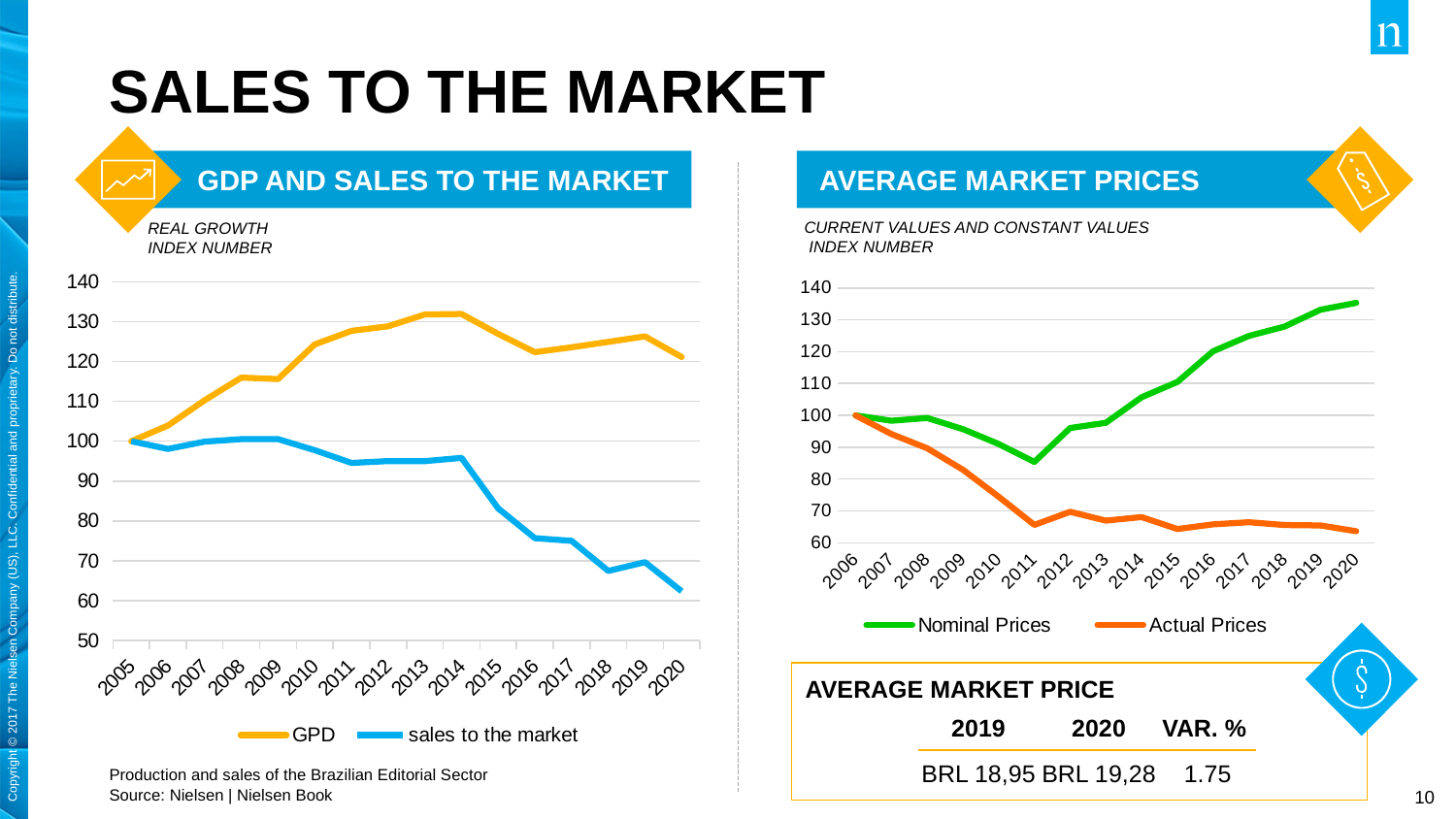
In the GDP AND SALES TO THE MARKET chart, in which year is sales to the market lowest? 2020 In the AVERAGE MARKET PRICES chart, what is the value of Nominal Prices in 2006? 100 In the GDP AND SALES TO THE MARKET chart, how many series does the legend list? 2 In the GDP AND SALES TO THE MARKET chart, which series is higher in 2014, GPD or sales to the market? GPD In the AVERAGE MARKET PRICES chart, in which year are Nominal Prices highest? 2020 In the AVERAGE MARKET PRICES chart, is the value for Actual Prices in 2020 greater or less than 70? less In the GDP AND SALES TO THE MARKET chart, does sales to the market rise or fall from 2014 to 2020? fall In the AVERAGE MARKET PRICES chart, how many series does the legend list? 2 In the GDP AND SALES TO THE MARKET chart, how many years are plotted on the x axis? 16 In the GDP AND SALES TO THE MARKET chart, what kind of chart is used? line chart In the GDP AND SALES TO THE MARKET chart, what is the value of GPD in 2005? 100 In the GDP AND SALES TO THE MARKET chart, is the value for sales to the market in 2020 greater or less than 70? less